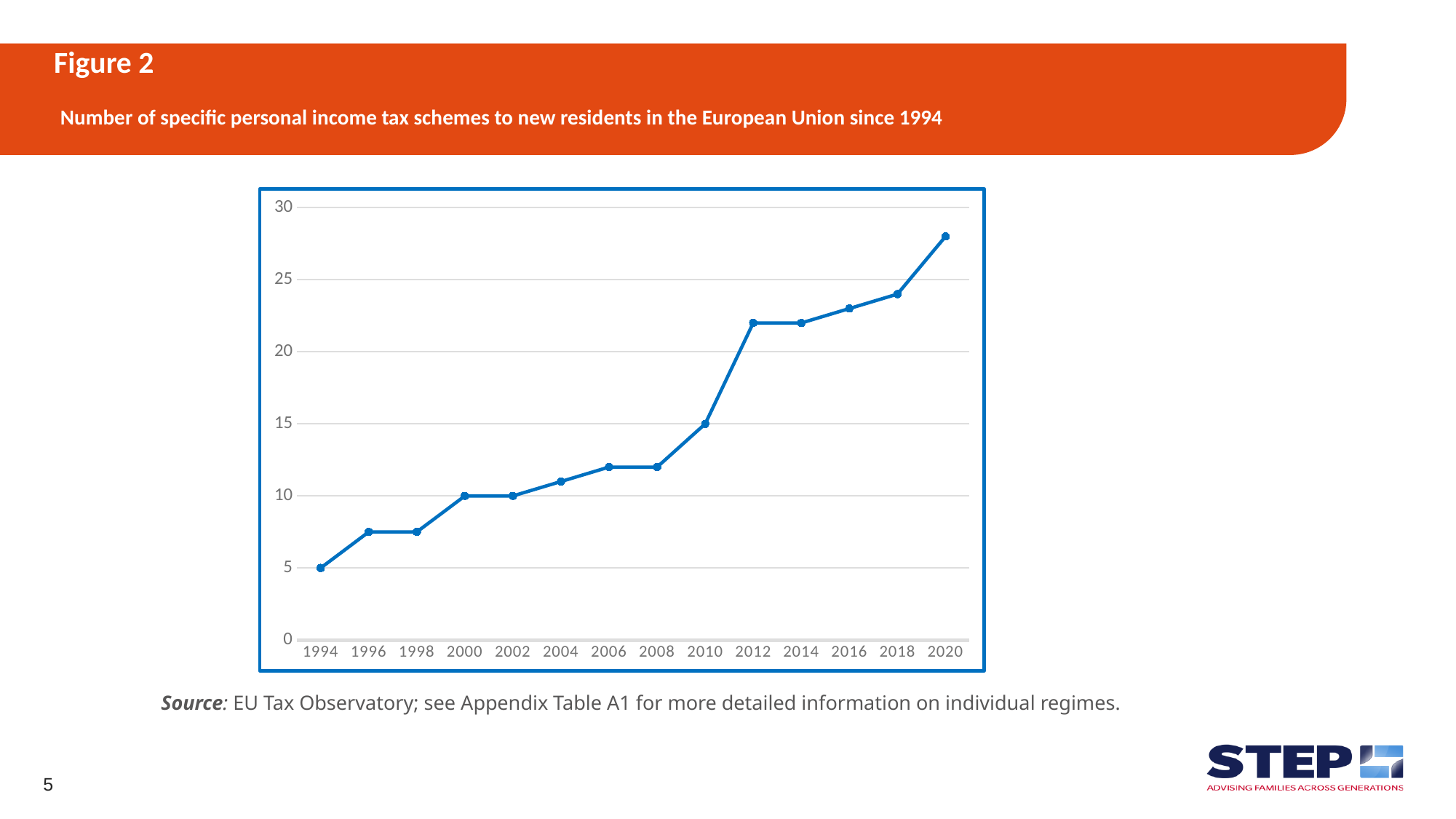
Which is larger, the value for 2010 or the value for 2008? 2010 Is the value for 2018 greater or less than 25? less What is the value for 1994? 5 What is the value for 2010? 15 Which year has the lowest value? 1994 What is the value for 2000? 10 Is the value for 1996 greater or less than 10? less How many years are plotted on the x axis? 14 What is the difference between the value for 2010 and the value for 1994? 10 Which year has the highest value? 2020 Is the value for 2020 greater or less than 25? greater What kind of chart is shown on the slide? line chart